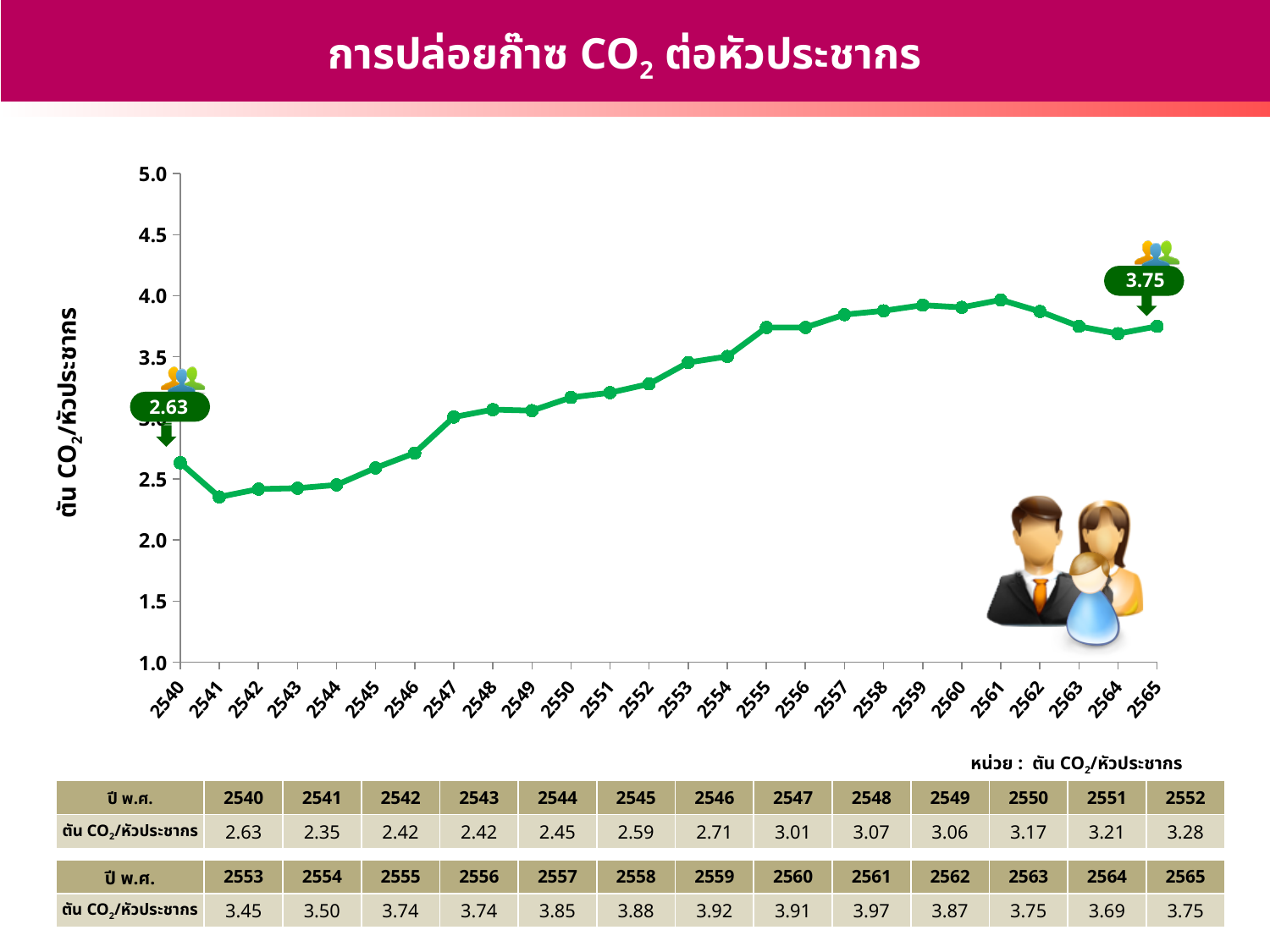
Which year has the larger value, 2546 or 2547? 2547 What kind of chart is shown on the slide? Line chart Is the value for 2550 greater or less than 3.0? greater What is the title of the chart on the slide? การปล่อยก๊าซ CO2 ต่อหัวประชากร Do the values generally rise or fall from 2540 to 2565? Rise How many years (data points) are plotted on the chart? 26 What is the CO2 emission per capita value for the year 2565? 3.75 Which year has the lowest CO2 emission per capita? 2541 What is the difference between the values for 2565 and 2540? 1.12 What is the value plotted for the year 2547? 3.01 Which year has the highest CO2 emission per capita? 2561 What is the CO2 emission per capita value for the year 2540? 2.63